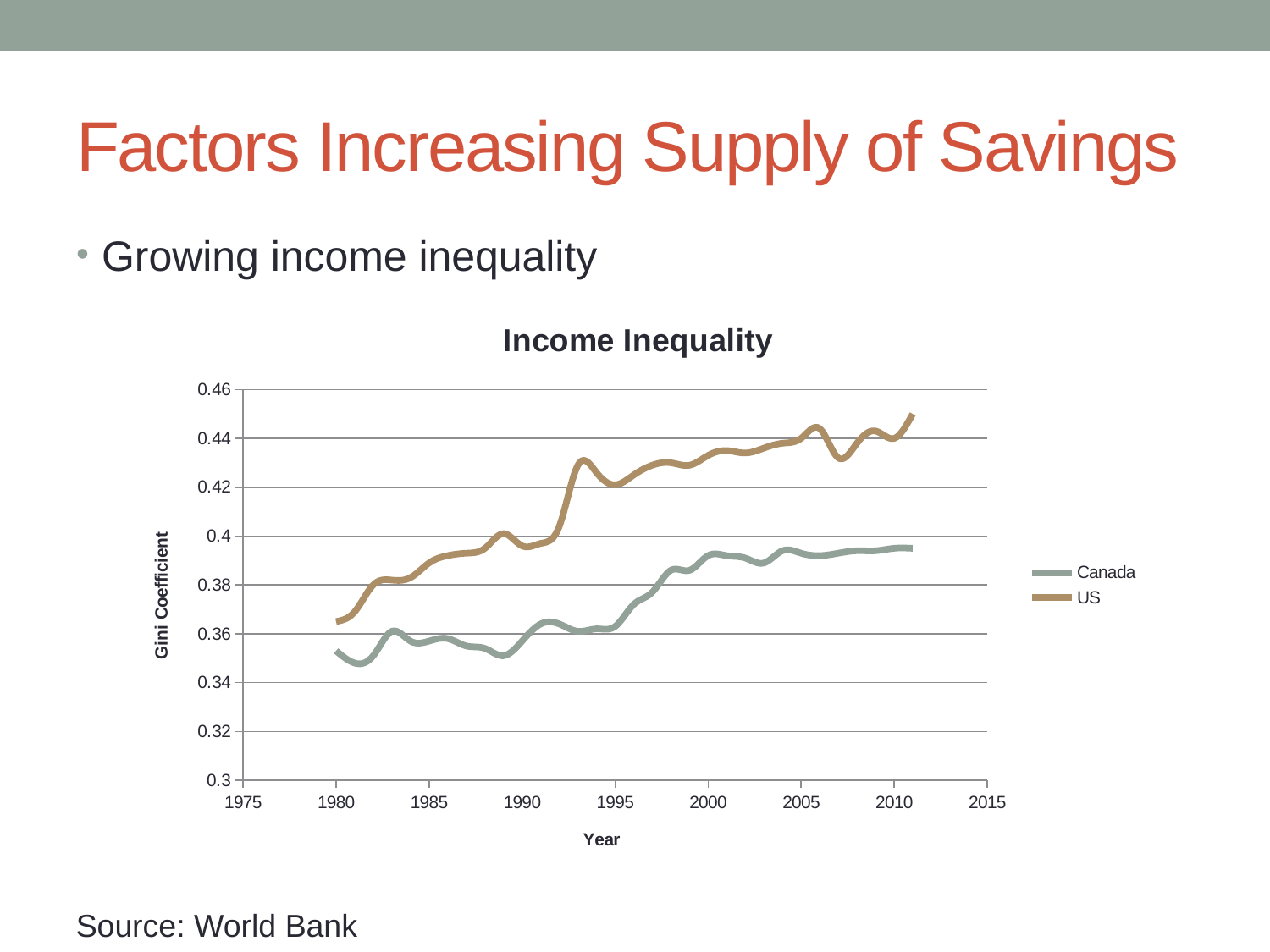
What kind of chart is shown on the slide? line chart Is the value for Canada in 1980 greater or less than 0.36? less Is the value for Canada in 2010 greater or less than 0.4? less Which series is higher across the whole period shown, Canada or US? US What is the title of the chart? Income Inequality What is the label of the vertical axis? Gini Coefficient Does the US Gini coefficient generally rise or fall from 1980 to 2010? rise Which series has the higher Gini coefficient in 2000, Canada or US? US Is the value for US in 1985 greater or less than 0.38? greater How many series does the legend list? 2 Does the Canada Gini coefficient generally rise or fall from 1980 to 2010? rise